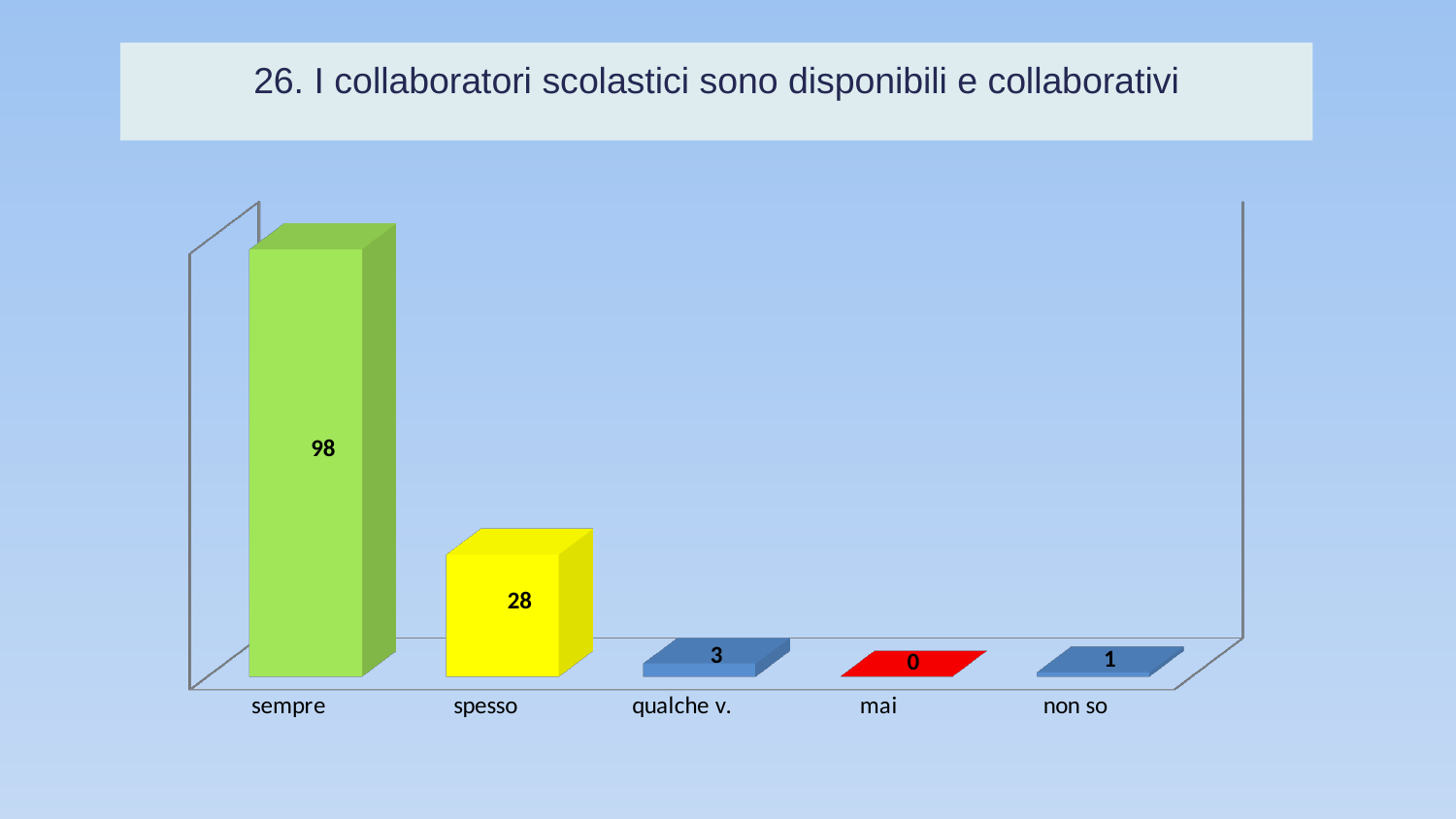
Which is larger, the value for "qualche v." or the value for "non so"? qualche v. What is the value for "sempre"? 98 Which category has the lowest value? mai What is the value for "mai"? 0 What kind of chart is shown on the slide? bar chart What is the difference between the values for "sempre" and "spesso"? 70 What is the value for "spesso"? 28 Which category has the highest value? sempre How many categories are shown on the x axis? 5 What is the title of the slide? 26. I collaboratori scolastici sono disponibili e collaborativi What is the value for "non so"? 1 What is the value for "qualche v."? 3